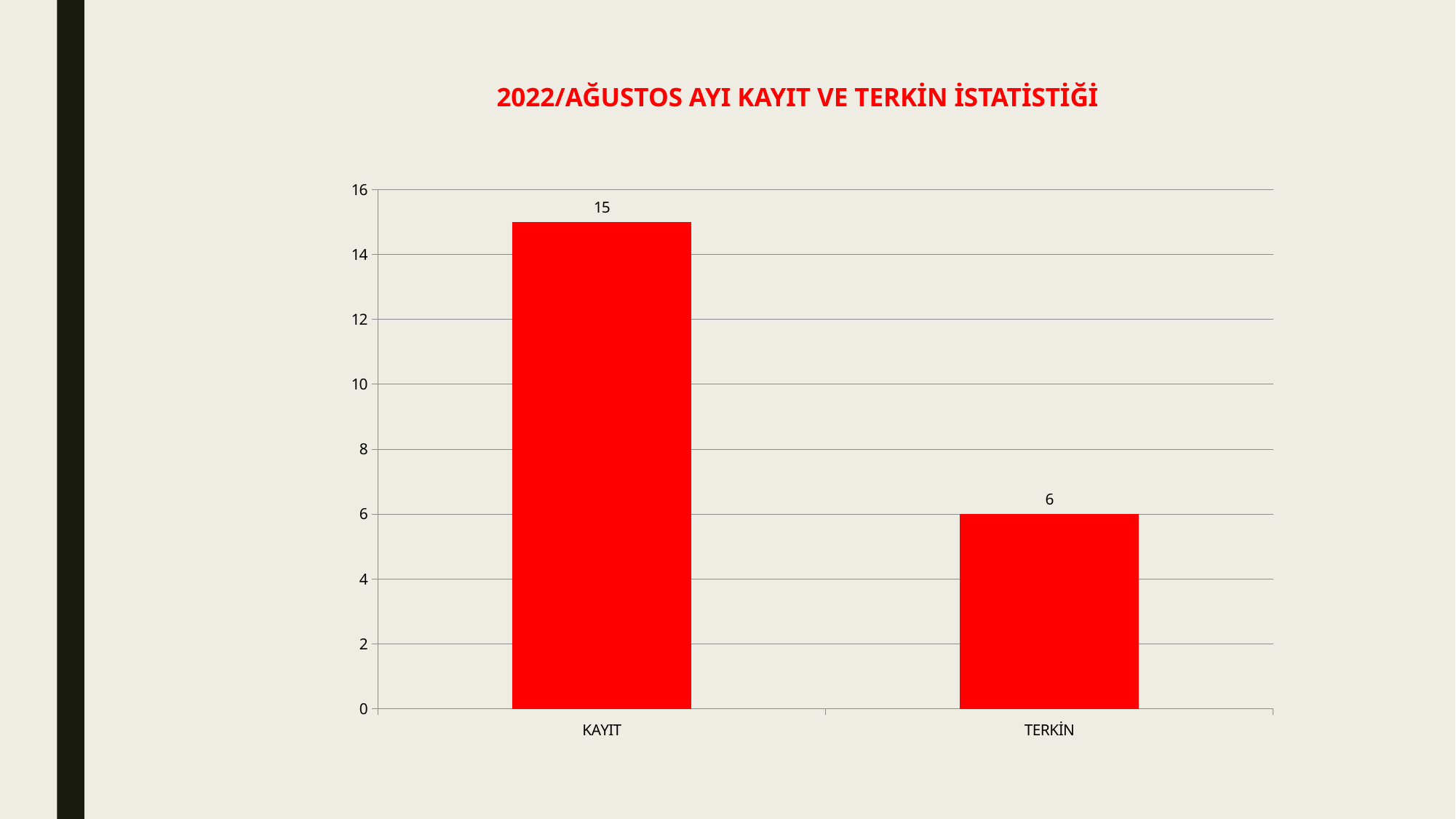
What is the difference between the values for KAYIT and TERKİN? 9 What is the value for TERKİN? 6 Which category has the lowest value? TERKİN What colour are the bars in the chart? red Which is larger, the value for KAYIT or the value for TERKİN? KAYIT How many categories are shown on the x axis? 2 What is the title of the chart? 2022/AĞUSTOS AYI KAYIT VE TERKİN İSTATİSTİĞİ What kind of chart is shown on the slide? bar chart What is the value for KAYIT? 15 Which category has the highest value? KAYIT Is the value for KAYIT greater or less than 10? greater Is the value for TERKİN greater or less than 8? less